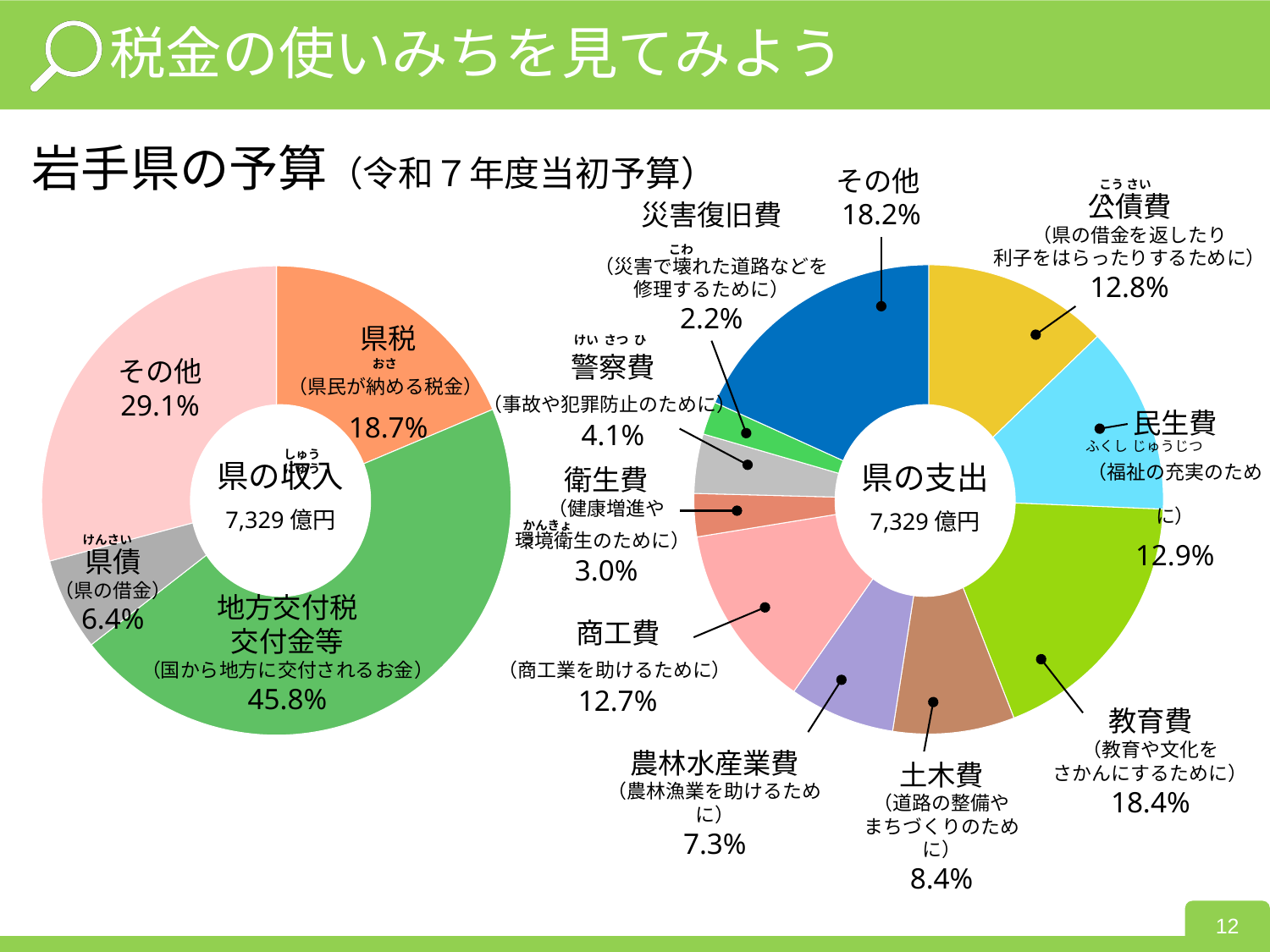
In the 県の収入 chart on the left, what share is 県税? 18.7% In the 県の支出 chart on the right, what share is 土木費? 8.4% In the 県の支出 chart on the right, which is larger, 民生費 or 公債費? 民生費 In the 県の収入 chart on the left, what is the difference between その他 and 県債? 22.7% In the 県の支出 chart on the right, what is the difference between 商工費 and 農林水産業費? 5.4% In the 県の支出 chart on the right, which category has the smallest share? 災害復旧費 In the 県の支出 chart on the right, how many categories are shown? 10 In the 県の収入 chart on the left, which category has the smallest share? 県債 What type of chart is used for 県の収入 and 県の支出? Pie (donut) chart In the 県の収入 chart on the left, what total amount is shown in the centre? 7,329 億円 In the 県の収入 chart on the left, what share is 地方交付税交付金等? 45.8% In the 県の支出 chart on the right, what share is 教育費? 18.4%